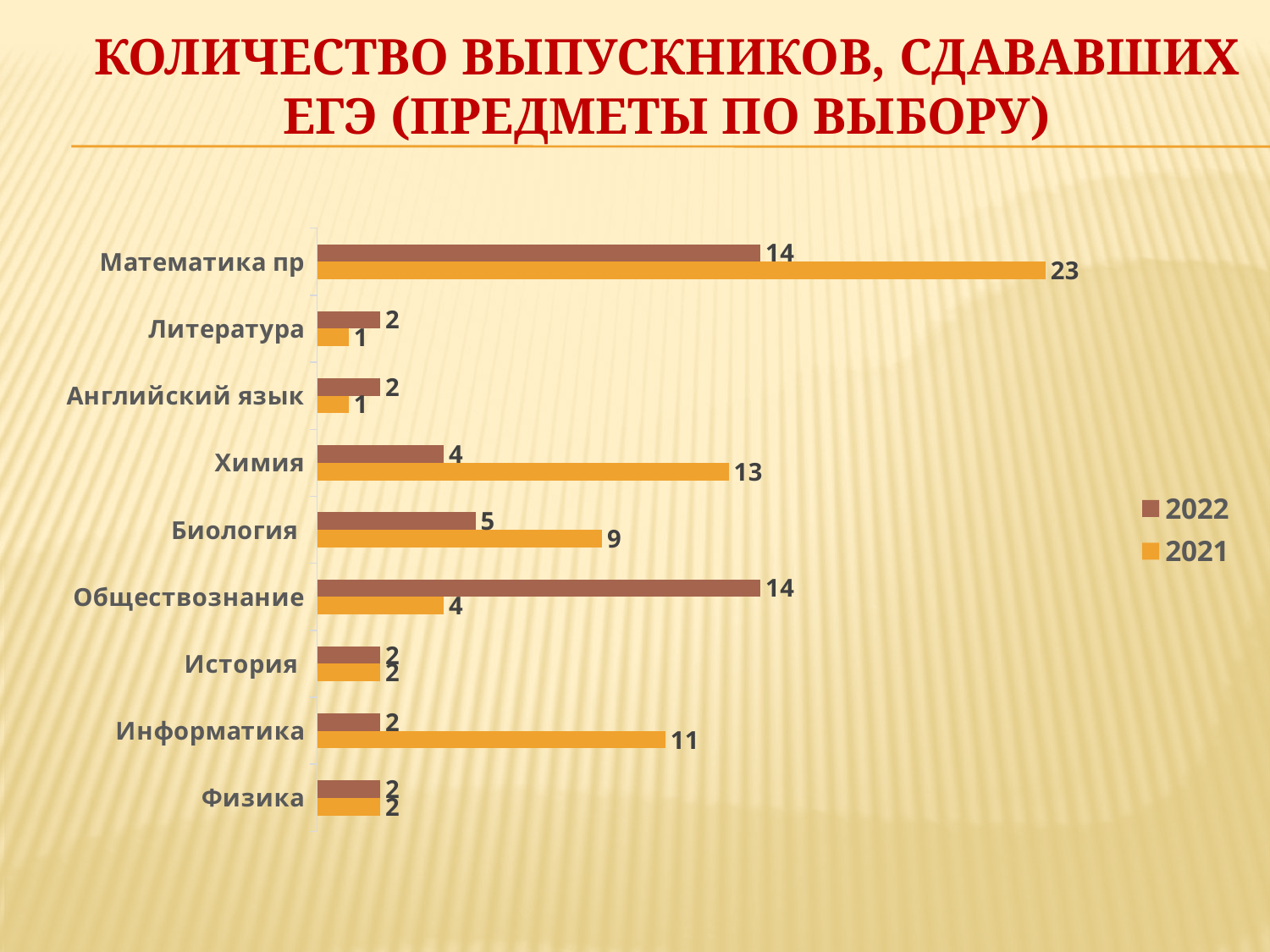
How many series does the legend list? 2 What is the difference between the 2021 and 2022 values for Химия? 9 How many categories are shown on the chart? 9 What is the value for Математика пр in the 2021 series? 23 Which category has the lowest value in the 2021 series? Литература and Английский язык What is the value for Обществознание in the 2022 series? 14 What is the value for Информатика in the 2021 series? 11 What is the difference between the 2021 and 2022 values for Математика пр? 9 What kind of chart is shown on the slide? Bar chart What is the value for Химия in the 2022 series? 4 Which is larger for Обществознание: the 2022 value or the 2021 value? 2022 Which category has the highest value in the 2021 series? Математика пр